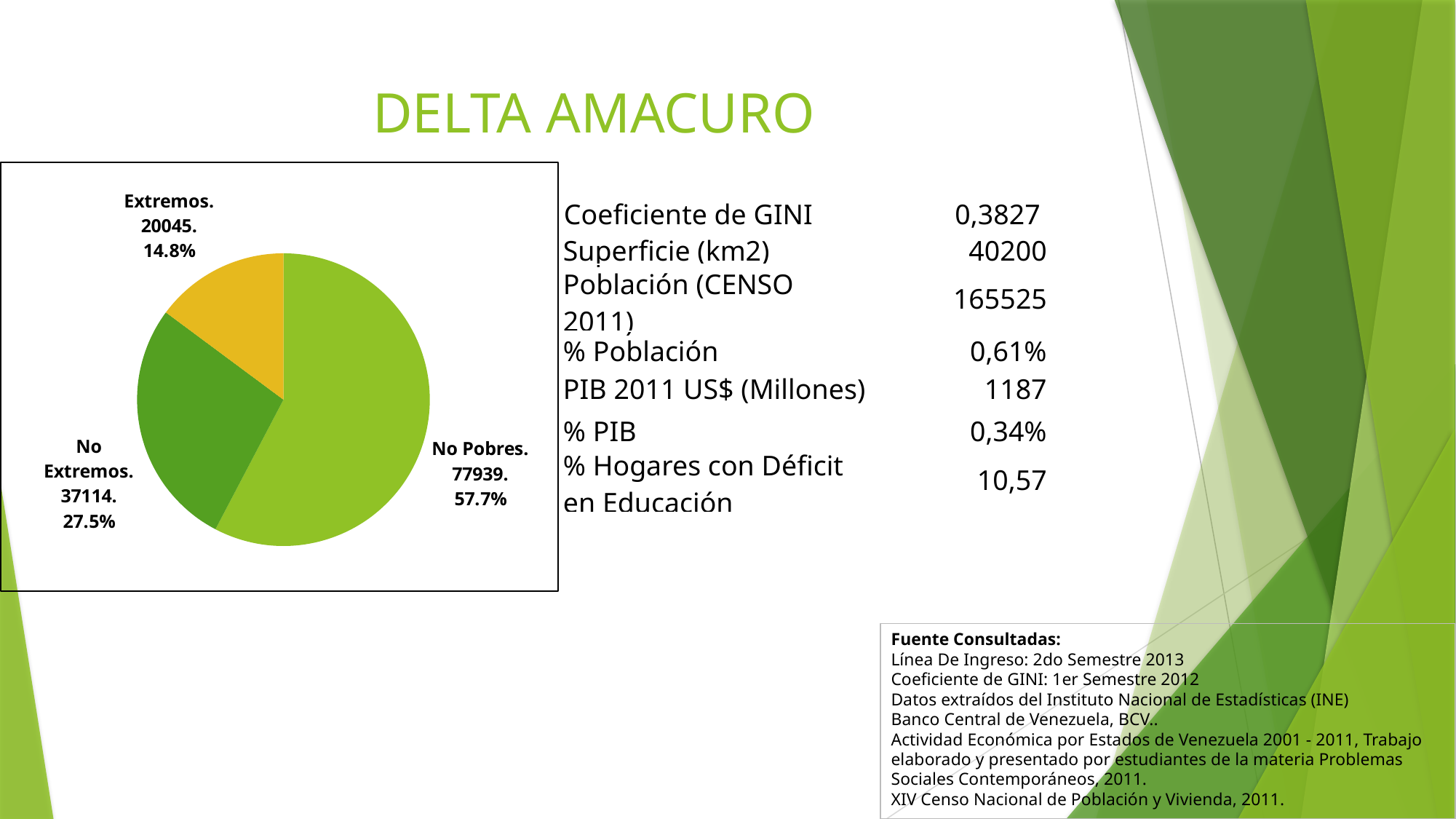
Which slice of the pie chart is the smallest? Extremos What is the difference between the No Extremos value and the Extremos value? 17069 What share of the pie does the Extremos slice represent? 14.8% What kind of chart is shown on the slide? pie chart What is the value shown for the Extremos slice? 20045 What share of the pie does the No Extremos slice represent? 27.5% What share of the pie does the No Pobres slice represent? 57.7% What is the value shown for the No Extremos slice? 37114 Which slice is larger, No Extremos or Extremos? No Extremos How many slices does the pie chart have? 3 Which slice of the pie chart is the largest? No Pobres What is the value shown for the No Pobres slice? 77939